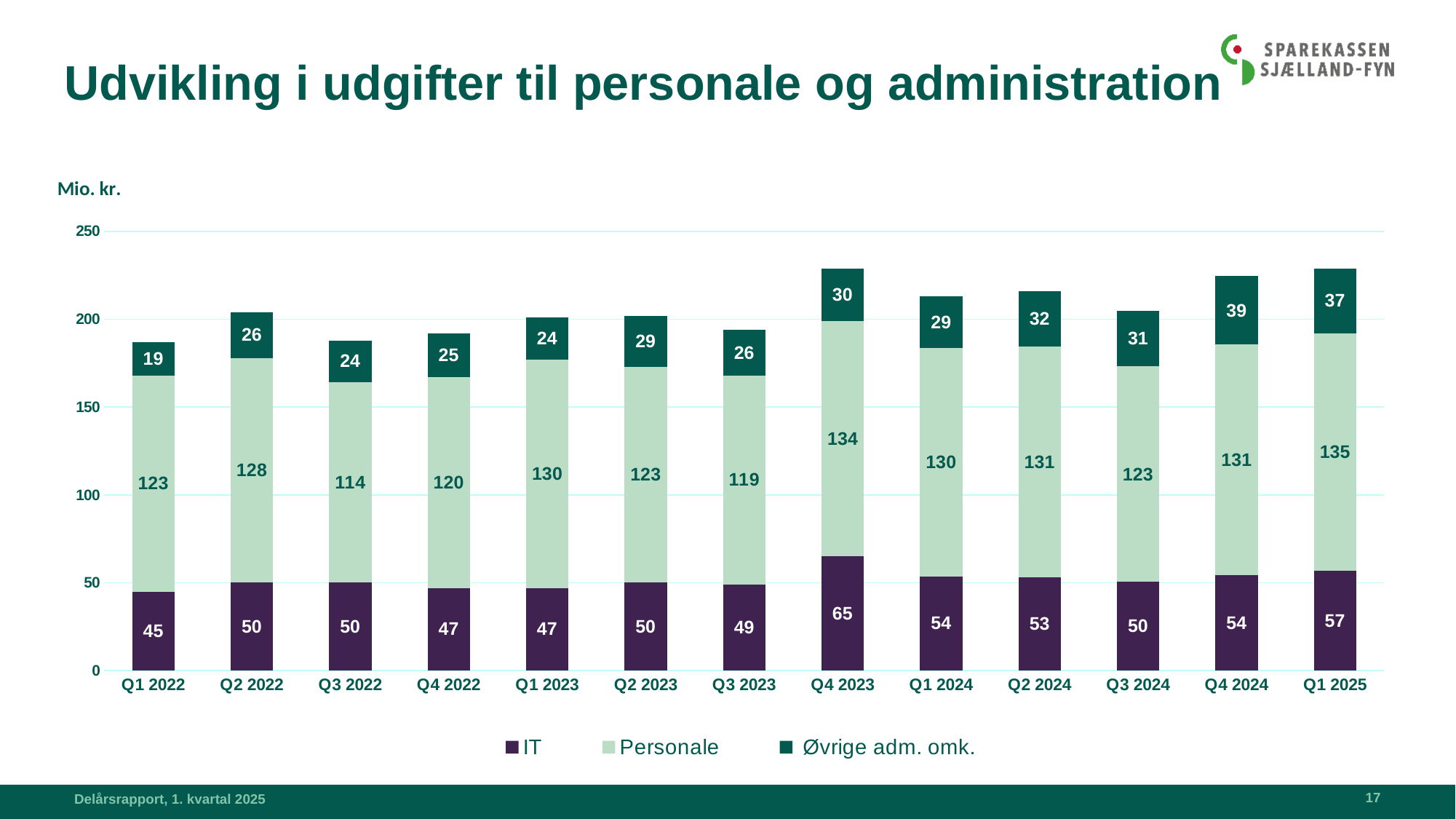
What is the Øvrige adm. omk. value for Q4 2024? 39 In which quarter is the IT value highest? Q4 2023 What is the difference between the Personale value in Q1 2025 and in Q1 2022? 12 What type of chart is shown on the slide? Stacked bar chart What is the Personale value for Q1 2025? 135 What is the IT value for Q4 2023? 65 Which is larger, the Øvrige adm. omk. value in Q4 2024 or in Q1 2025? Q4 2024 In which quarter is the Øvrige adm. omk. value lowest? Q1 2022 How many quarters are shown on the x axis? 13 What is the total of the stacked bar for Q1 2025? 229 How many series does the legend list? 3 In which quarter is the Personale value lowest? Q3 2022